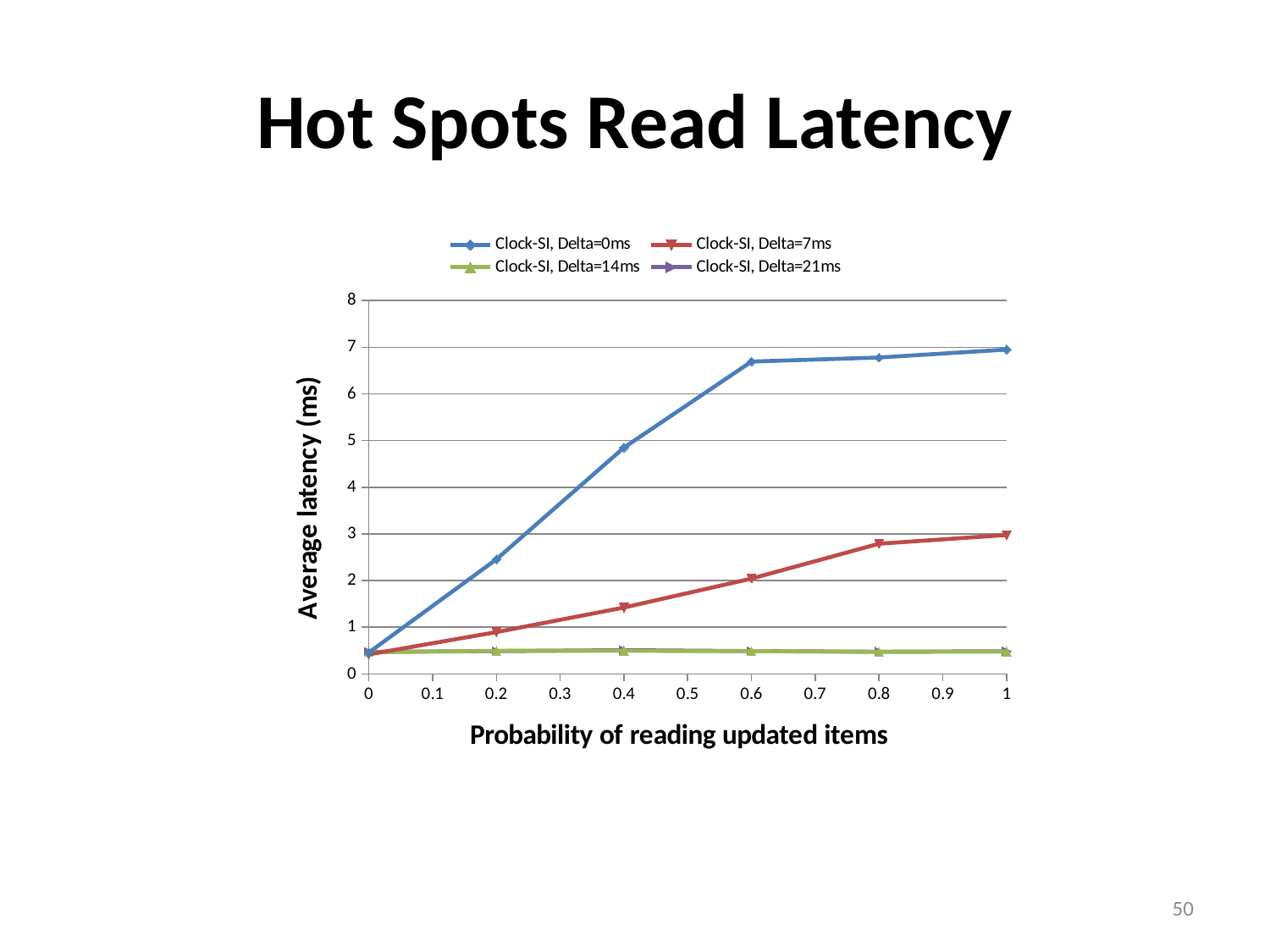
What is the label of the y axis? Average latency (ms) Is the value for Clock-SI, Delta=14ms at probability 1 greater or less than 1? less Does the average latency for Clock-SI, Delta=0ms rise or fall as the probability of reading updated items increases? rise Is the value for Clock-SI, Delta=7ms at probability 0.4 greater or less than 2? less How many data points are plotted for the Clock-SI, Delta=0ms series? 6 How many series does the legend list? 4 At probability 0.8, which is larger: the value for Clock-SI, Delta=0ms or Clock-SI, Delta=7ms? Clock-SI, Delta=0ms What kind of chart is shown on the slide? line chart Is the value for Clock-SI, Delta=0ms at probability 0.6 greater or less than 6? greater Which series has the highest average latency at probability 1? Clock-SI, Delta=0ms What is the title of the chart on the slide? Hot Spots Read Latency